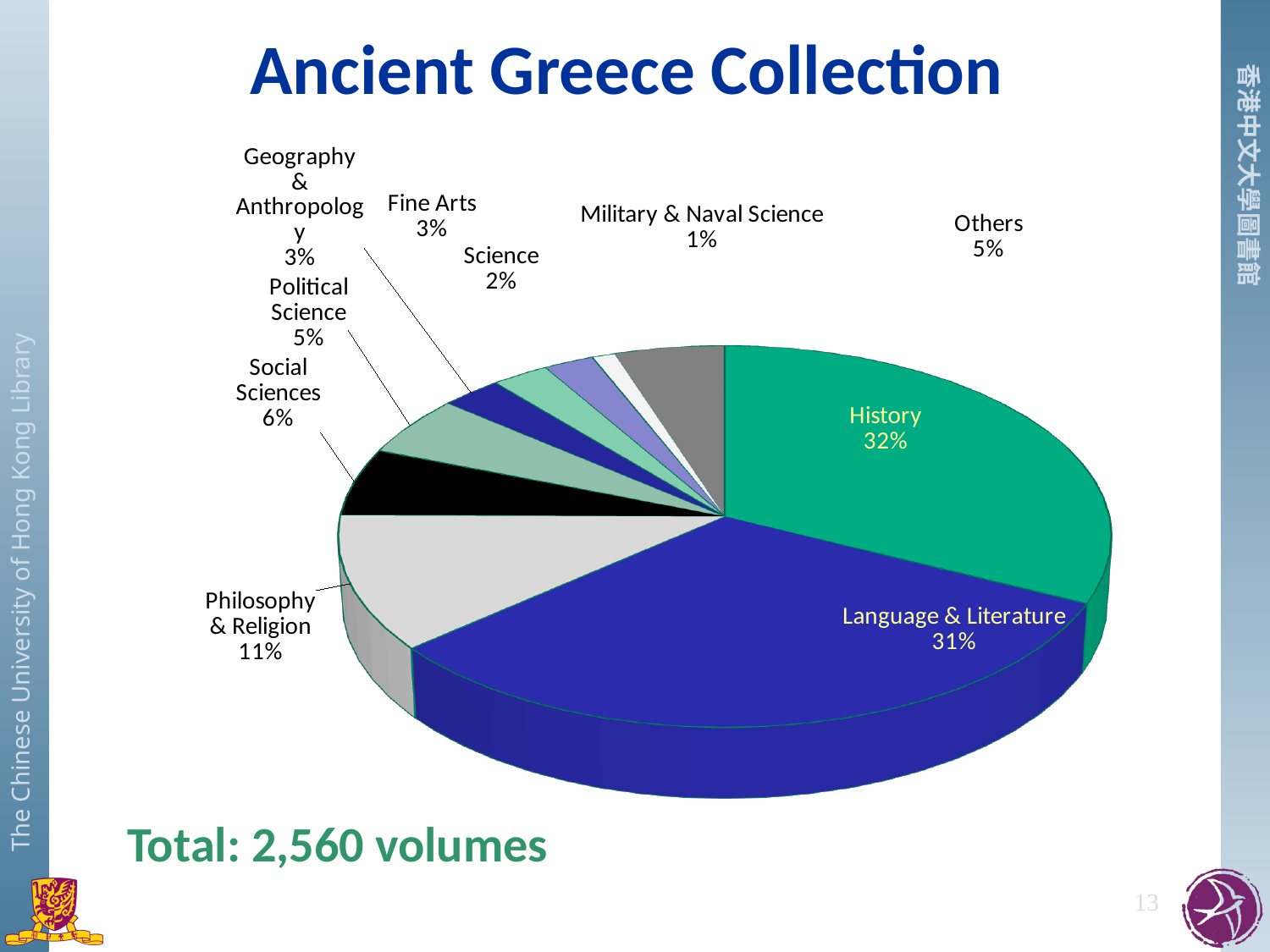
Which category has the smallest share of the collection? Military & Naval Science What share of the Ancient Greece Collection is History? 32% How many percentage points larger is Philosophy & Religion than Social Sciences? 5 What share of the collection is Language & Literature? 31% How many categories are shown in the pie chart? 10 Which is larger, the share for Political Science or the share for Science? Political Science What kind of chart is shown on the slide? Pie chart What is the total number of volumes stated on the slide? 2,560 volumes What percentage of the collection is Philosophy & Religion? 11% What percentage of the collection is Military & Naval Science? 1% What is the title of the chart? Ancient Greece Collection Which category has the largest share of the collection? History